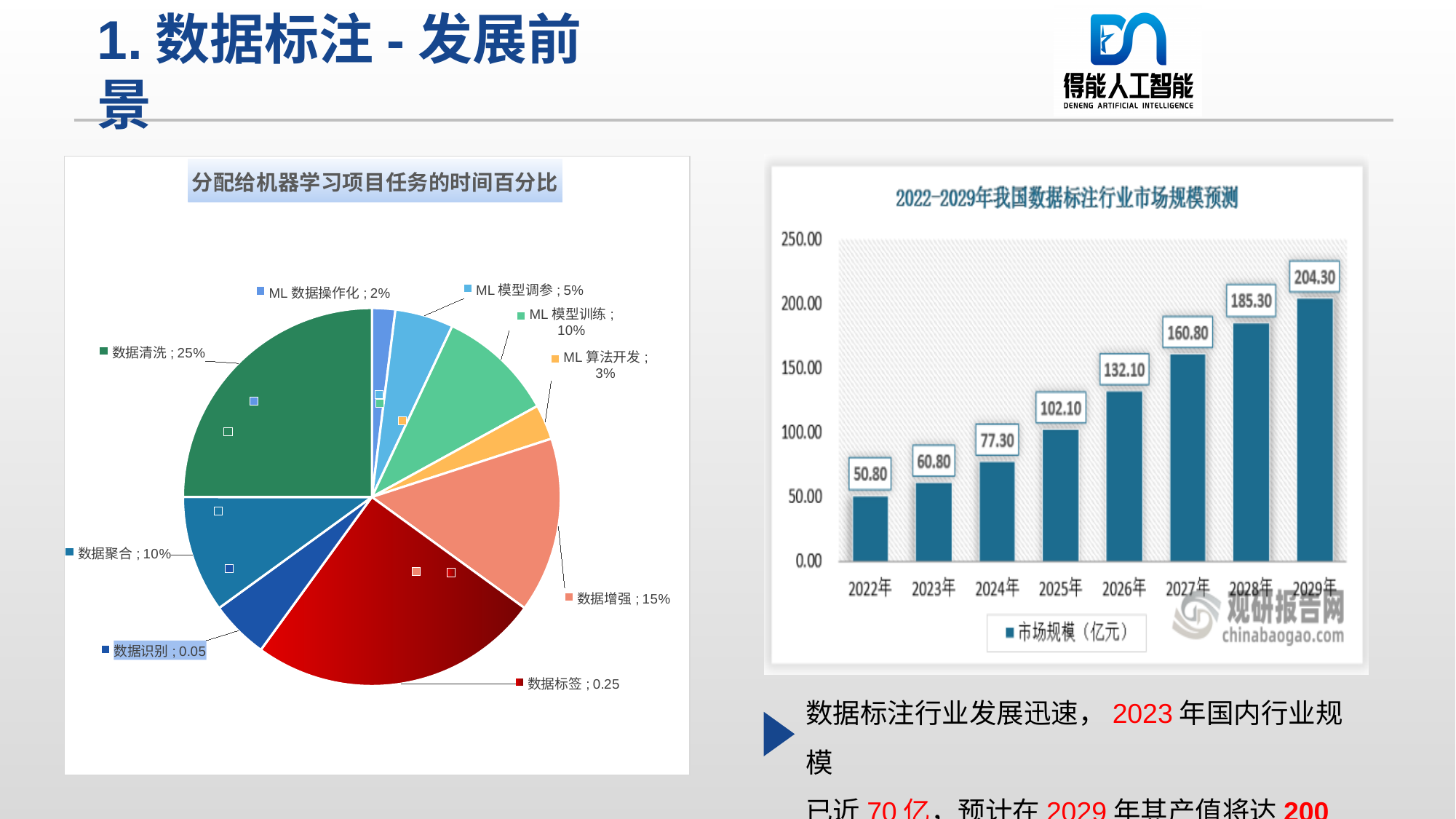
In the bar chart titled 2022-2029年我国数据标注行业市场规模预测, what is the legend entry? 市场规模（亿元） In the bar chart titled 2022-2029年我国数据标注行业市场规模预测, which year has the highest value? 2029年 In the bar chart titled 2022-2029年我国数据标注行业市场规模预测, what is the value for 2025年? 102.10 In the bar chart titled 2022-2029年我国数据标注行业市场规模预测, what is the difference between the values for 2029年 and 2028年? 19.00 In the pie chart titled 分配给机器学习项目任务的时间百分比, which slice is the smallest? ML 数据操作化 What kind of chart is the chart on the left of the slide, titled 分配给机器学习项目任务的时间百分比? pie chart In the bar chart titled 2022-2029年我国数据标注行业市场规模预测, how many years are shown on the x axis? 8 In the bar chart titled 2022-2029年我国数据标注行业市场规模预测, what is the value for 2022年? 50.80 In the pie chart titled 分配给机器学习项目任务的时间百分比, what is the value for 数据清洗? 25% In the pie chart titled 分配给机器学习项目任务的时间百分比, how many slices are there? 9 In the pie chart titled 分配给机器学习项目任务的时间百分比, what is the value for ML 模型调参? 5% In the bar chart titled 2022-2029年我国数据标注行业市场规模预测, do the values rise or fall from 2022年 to 2029年? rise